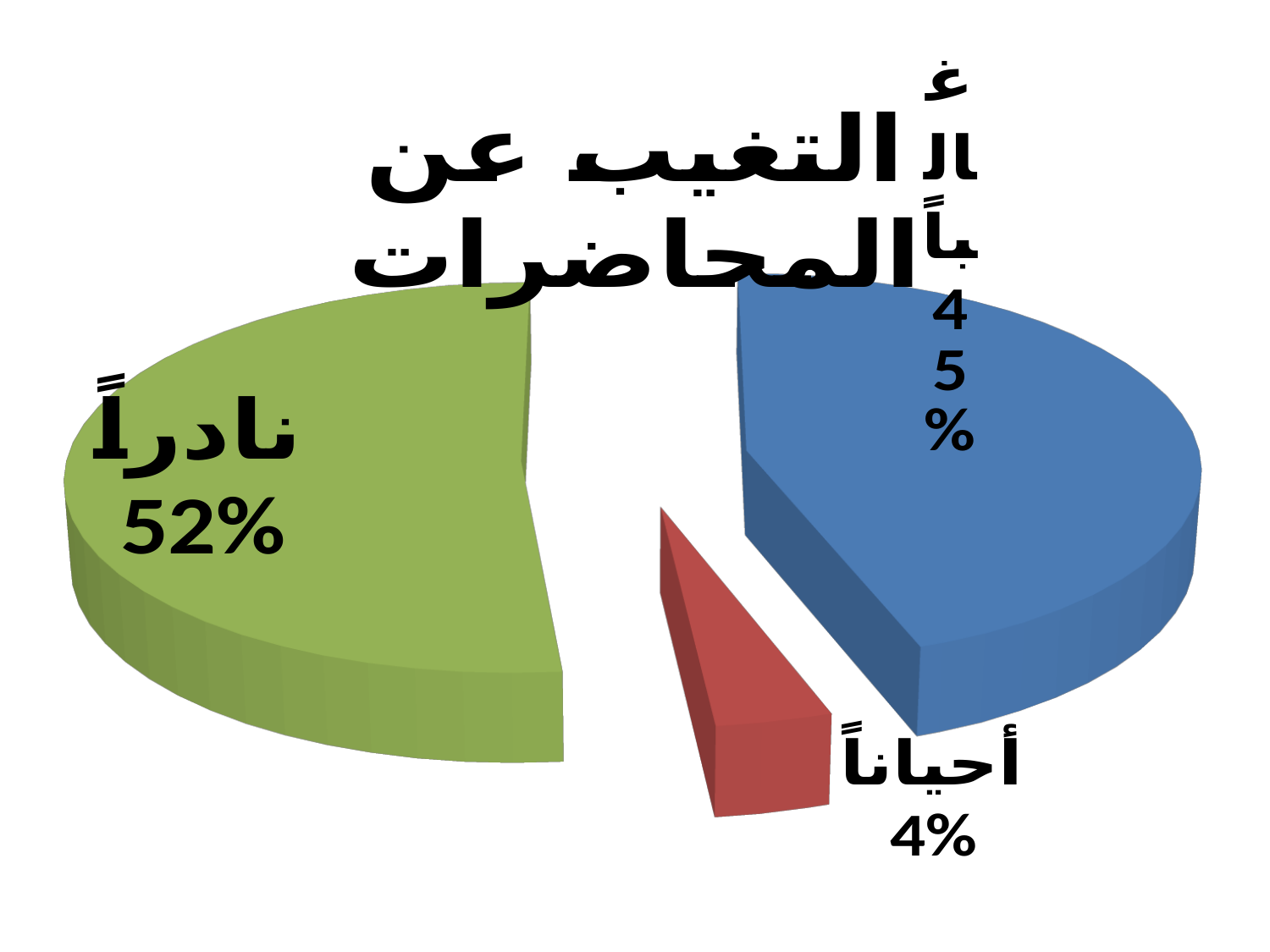
What percentage is shown on the blue slice of the pie? 45% What colour is the slice labelled نادراً? green What is the title of the chart? التغيب عن المحاضرات What percentage is shown for نادراً? 52% Which is larger, the share for نادراً or the share for أحياناً? نادراً What is the difference in percentage points between نادراً and the blue slice? 7 Which category has the smallest share of the pie? أحياناً What is the difference in percentage points between نادراً and أحياناً? 48 How many slices does the pie chart have? 3 What kind of chart is shown on the slide? pie chart Which category has the largest share of the pie? نادراً What percentage is shown for أحياناً? 4%